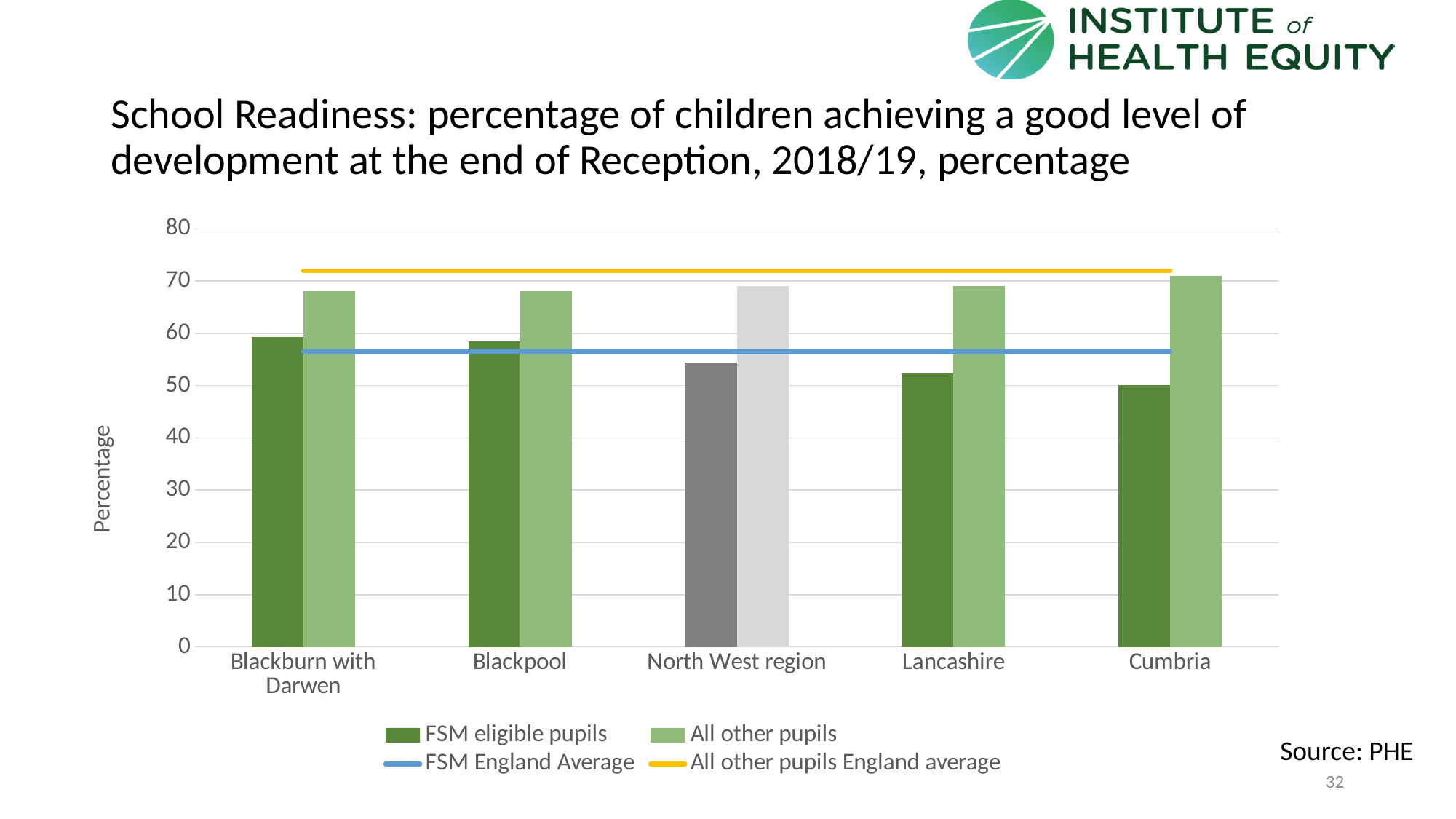
How many areas are shown along the x axis of the chart? 5 Which area has the lowest value for FSM eligible pupils? Cumbria Is the value for FSM eligible pupils in Blackburn with Darwen greater or less than 50? greater Which is larger: the FSM eligible pupils value for Lancashire or for Cumbria? Lancashire Is the value for All other pupils in Lancashire greater or less than 60? greater What is the label on the vertical axis of the chart? Percentage How many entries does the chart's legend list? 4 Which is larger: the All other pupils value for Cumbria or for Blackburn with Darwen? Cumbria Do the FSM eligible pupils values rise or fall moving from left to right across the x axis? fall Which area has the highest value for All other pupils? Cumbria Is the value for FSM eligible pupils in Cumbria greater or less than 60? less What kind of chart is shown on the slide? bar chart